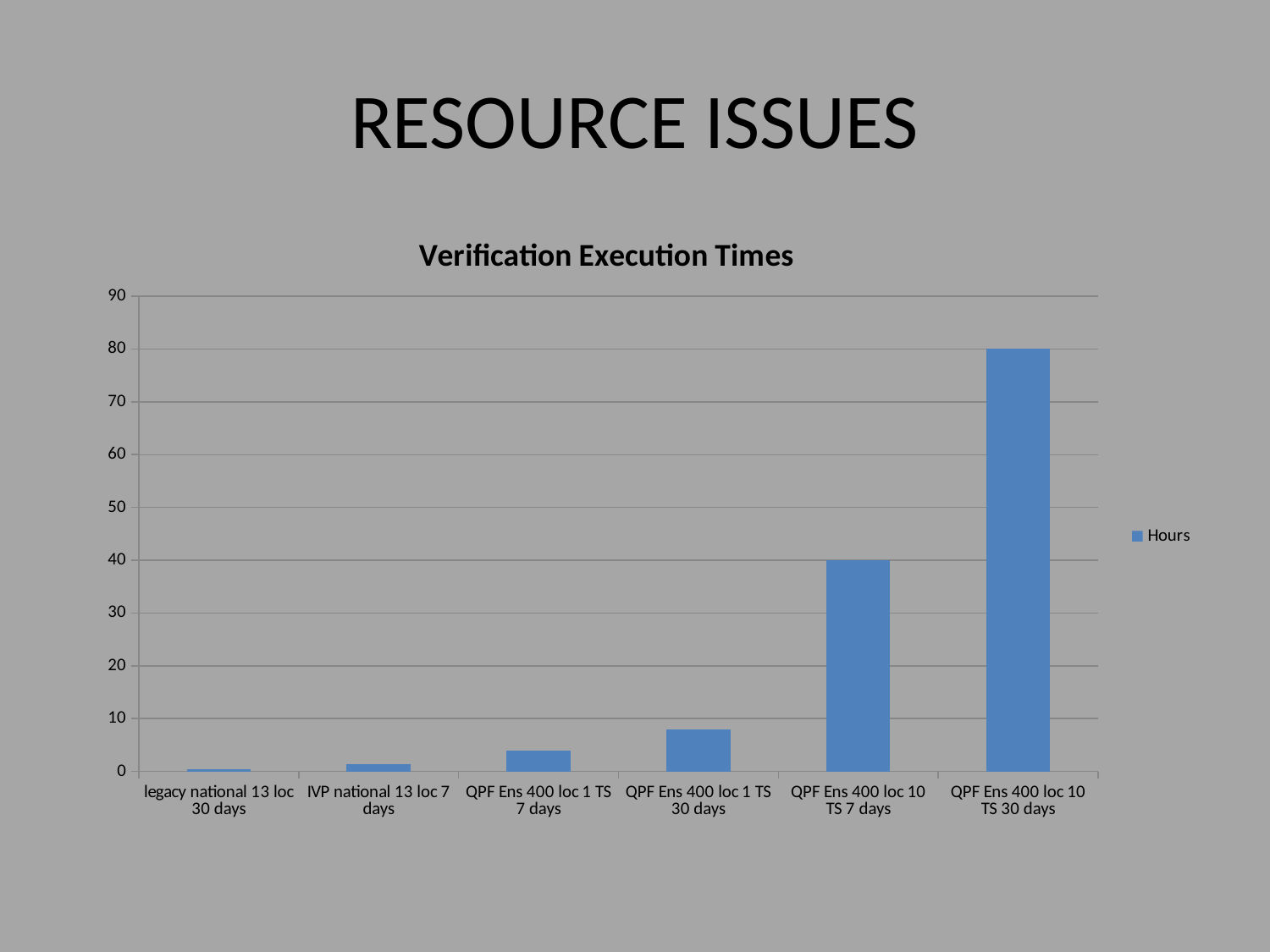
How many series does the legend list? 1 How many categories are shown on the x axis of the chart? 6 What is the title of the chart? Verification Execution Times What is the value for QPF Ens 400 loc 10 TS 30 days? 80 Which category has the lowest value? legacy national 13 loc 30 days What is the difference between the values for QPF Ens 400 loc 10 TS 30 days and QPF Ens 400 loc 10 TS 7 days? 40 What kind of chart is shown on the slide? bar chart What is the name of the series shown in the legend? Hours Which category has the highest value? QPF Ens 400 loc 10 TS 30 days Is the value for QPF Ens 400 loc 1 TS 30 days greater or less than 10? less Which is larger, the value for QPF Ens 400 loc 1 TS 7 days or the value for IVP national 13 loc 7 days? QPF Ens 400 loc 1 TS 7 days What is the value for QPF Ens 400 loc 10 TS 7 days? 40